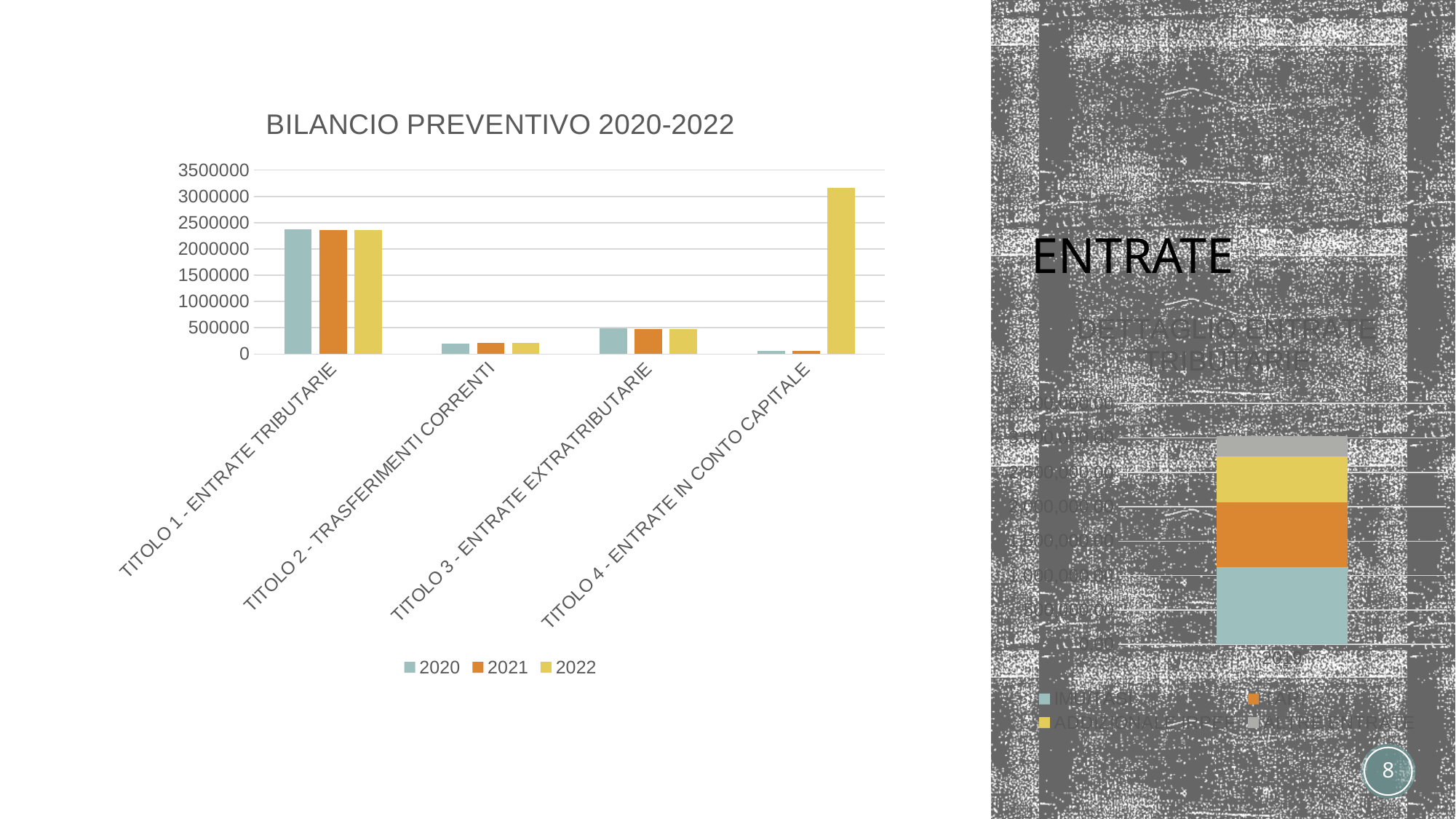
In the chart titled BILANCIO PREVENTIVO 2020-2022, which category has the highest value for 2022? TITOLO 4 - ENTRATE IN CONTO CAPITALE In the chart titled BILANCIO PREVENTIVO 2020-2022, which category has the lowest value for 2021? TITOLO 4 - ENTRATE IN CONTO CAPITALE What kind of chart is shown on the right side of the slide? stacked bar chart In the chart titled BILANCIO PREVENTIVO 2020-2022, what kind of chart is shown? bar chart In the chart titled BILANCIO PREVENTIVO 2020-2022, how many categories are shown on the x axis? 4 In the chart titled BILANCIO PREVENTIVO 2020-2022, which category has the highest value for 2020? TITOLO 1 - ENTRATE TRIBUTARIE In the chart titled BILANCIO PREVENTIVO 2020-2022, is the 2020 value for TITOLO 1 - ENTRATE TRIBUTARIE greater or less than 2000000? greater In the chart titled BILANCIO PREVENTIVO 2020-2022, what are the legend entries? 2020, 2021, 2022 In the chart titled BILANCIO PREVENTIVO 2020-2022, for 2020, which is larger: TITOLO 2 - TRASFERIMENTI CORRENTI or TITOLO 3 - ENTRATE EXTRATRIBUTARIE? TITOLO 3 - ENTRATE EXTRATRIBUTARIE In the chart titled BILANCIO PREVENTIVO 2020-2022, is the 2022 value for TITOLO 4 - ENTRATE IN CONTO CAPITALE greater or less than 2500000? greater In the chart titled BILANCIO PREVENTIVO 2020-2022, how many series does the legend list? 3 In the chart titled BILANCIO PREVENTIVO 2020-2022, is the 2021 value for TITOLO 2 - TRASFERIMENTI CORRENTI greater or less than 500000? less